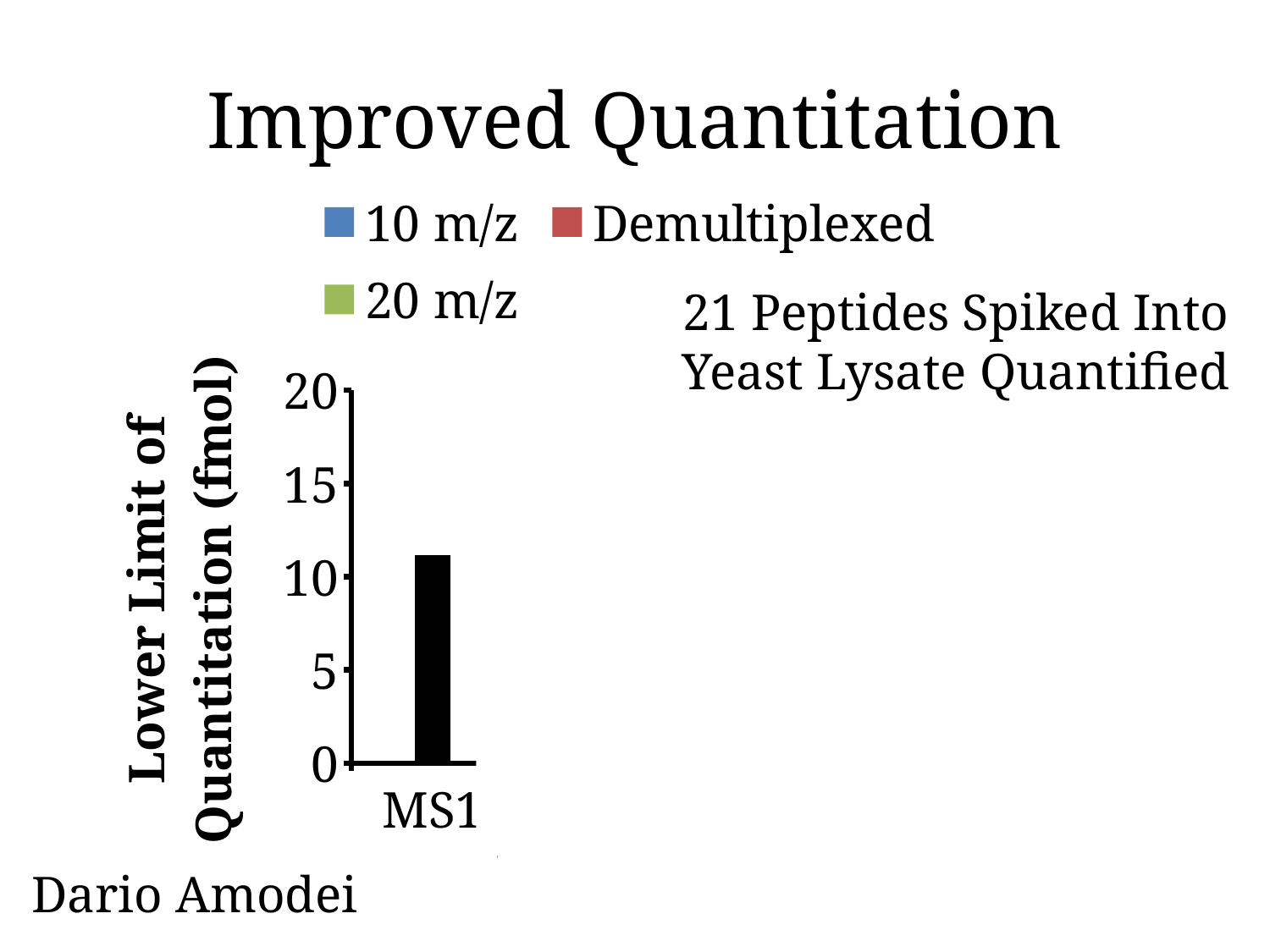
Is the value for MS1 greater or less than 15? less Is the value for MS1 greater or less than 10? greater What is the label of the category shown on the x axis? MS1 How many series does the legend list? 3 Is the value for MS1 greater or less than 5? greater What is the highest tick value shown on the y axis? 20 How many categories are shown on the x axis of the chart? 1 What is the label of the y axis? Lower Limit of Quantitation (fmol) What kind of chart is shown on the slide? bar chart